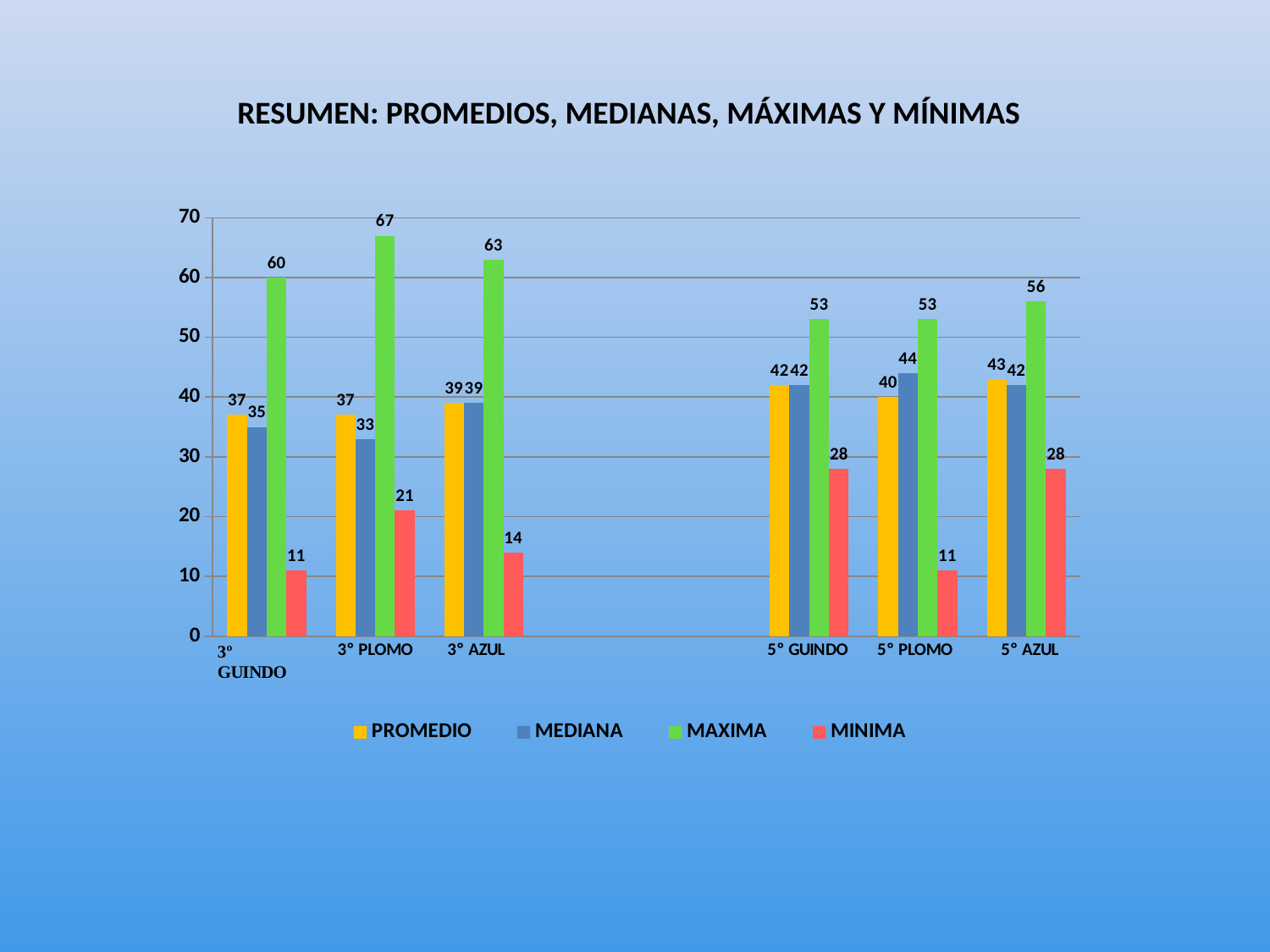
Which colour represents the MAXIMA series in the legend? Green What is the MINIMA value for 5° GUINDO? 28 Which category has the lowest MEDIANA value? 3° PLOMO How many series does the legend list? 4 What is the MEDIANA value for 5° PLOMO? 44 What kind of chart is shown on the slide? Bar chart How many categories are shown on the x axis? 6 What is the difference between the MAXIMA values for 3° AZUL and 5° AZUL? 7 Which category has the highest MAXIMA value? 3° PLOMO Which is larger, the MINIMA for 3° PLOMO or the MINIMA for 3° AZUL? 3° PLOMO What is the MAXIMA value for 3° PLOMO? 67 What is the PROMEDIO value for 3° AZUL? 39